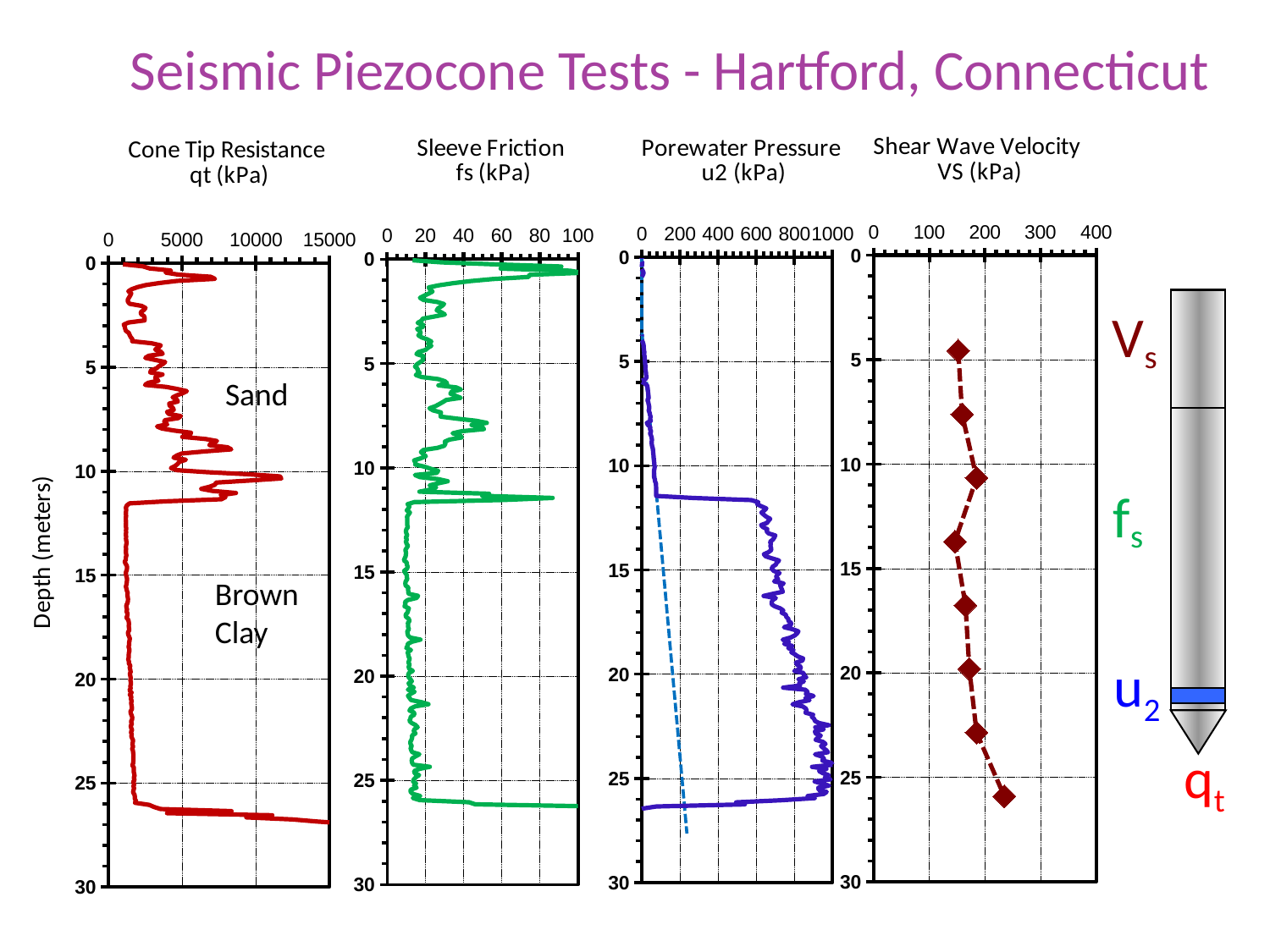
In the Sleeve Friction chart, is the value at 20 m depth greater or less than 40? less In the Shear Wave Velocity chart, is the value at the shallowest point (about 5 m) greater or less than 200? less How many charts are shown on the slide? 4 In the Cone Tip Resistance chart, is the value at 20 m depth greater or less than 5000? less In the Shear Wave Velocity chart, do the values generally increase or decrease with depth? increase What two soil layers are labelled on the Cone Tip Resistance chart? Sand and Brown Clay In the Shear Wave Velocity chart, how many data points are plotted? 8 What kind of chart is the Shear Wave Velocity chart? line chart with markers